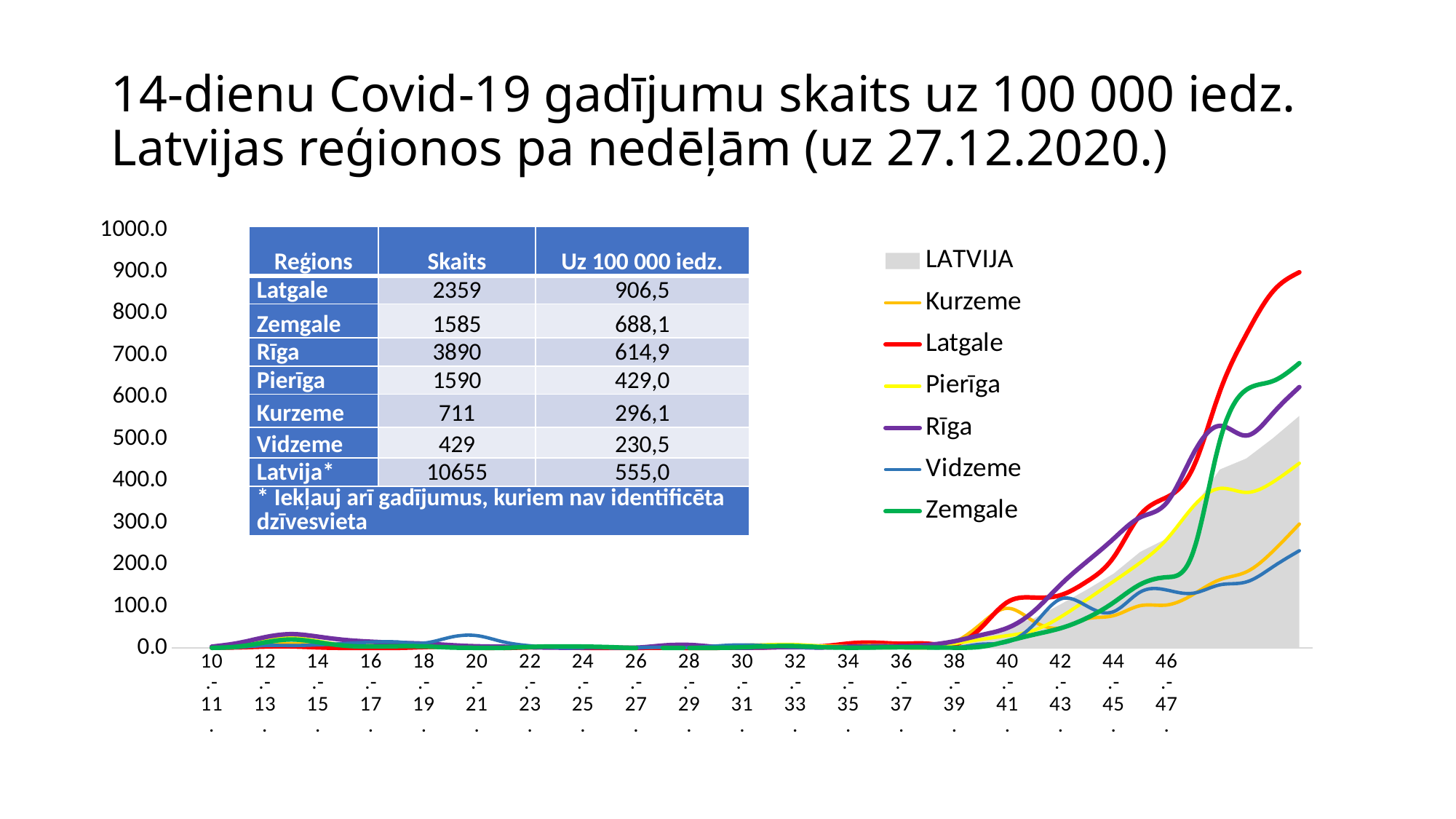
Do the values in the chart generally rise or fall from left to right along the x axis? rise According to the table on the slide, what is the value 'Uz 100 000 iedz.' for Latgale? 906,5 Which series is shown as a grey shaded area in the chart? LATVIJA At the right end of the chart, is the value for Latgale greater or less than 800? greater At the right end of the chart, is the value for Pierīga greater or less than 500? less Which region's line is lowest at the right end of the chart? Vidzeme What kind of chart is shown on the slide? combination area and line chart How many series does the chart legend list? 7 At the right end of the chart, is the value for Vidzeme greater or less than 300? less What colour is the Latgale line in the chart? red Which region's line is highest at the right end of the chart? Latgale At the right end of the chart, which line is higher: Zemgale or Rīga? Zemgale